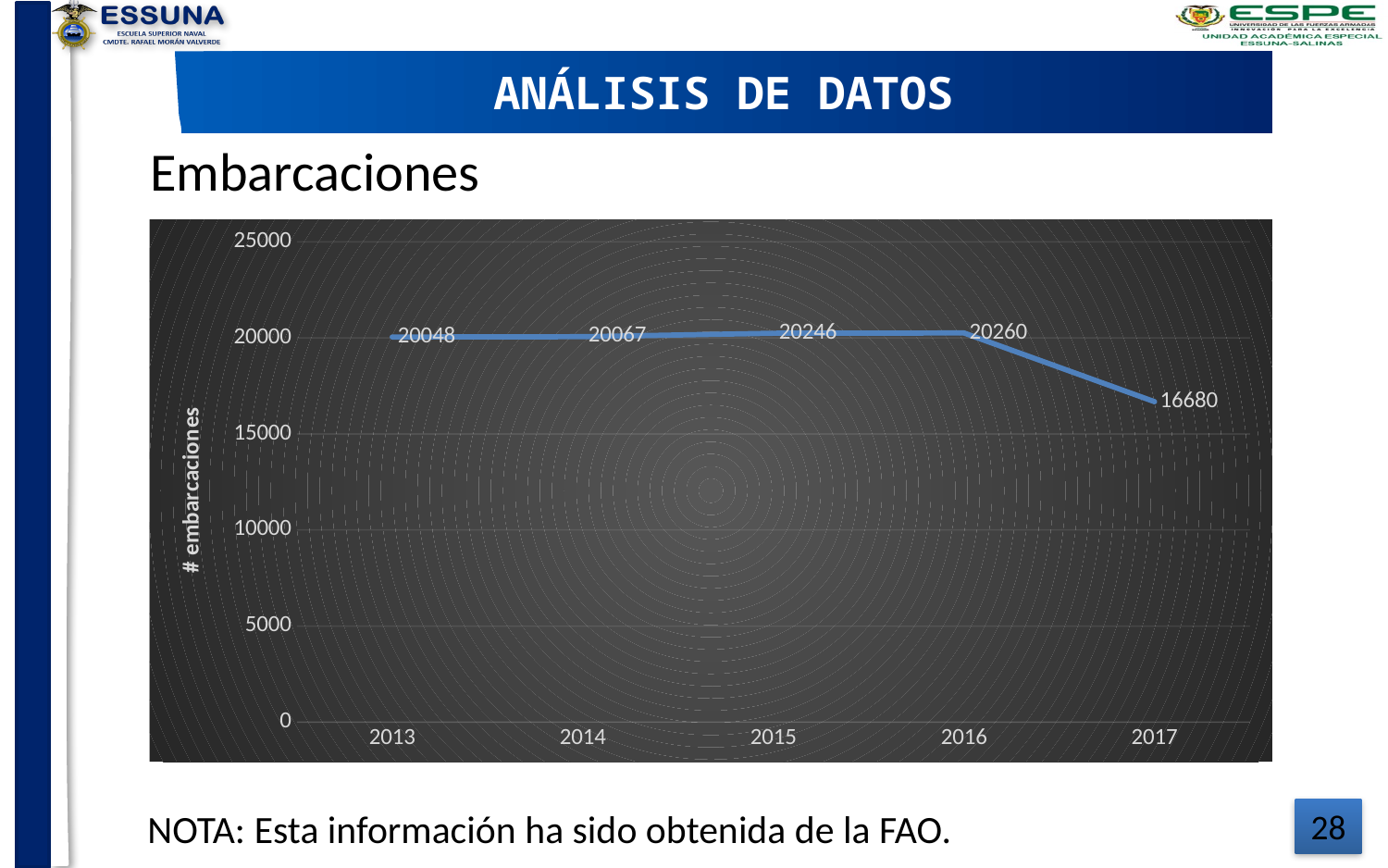
What is the difference between the values for 2016 and 2017? 3580 What is the number of embarcaciones in 2013? 20048 What is the number of embarcaciones in 2017? 16680 Which is larger, the value for 2014 or the value for 2017? 2014 What is the number of embarcaciones in 2015? 20246 What is the difference between the values for 2015 and 2014? 179 What is the label of the vertical axis? # embarcaciones Which year has the lowest number of embarcaciones? 2017 Which year has the highest number of embarcaciones? 2016 Is the value for 2017 greater or less than 20000? less What kind of chart is shown on the slide? line chart How many years are plotted on the chart? 5